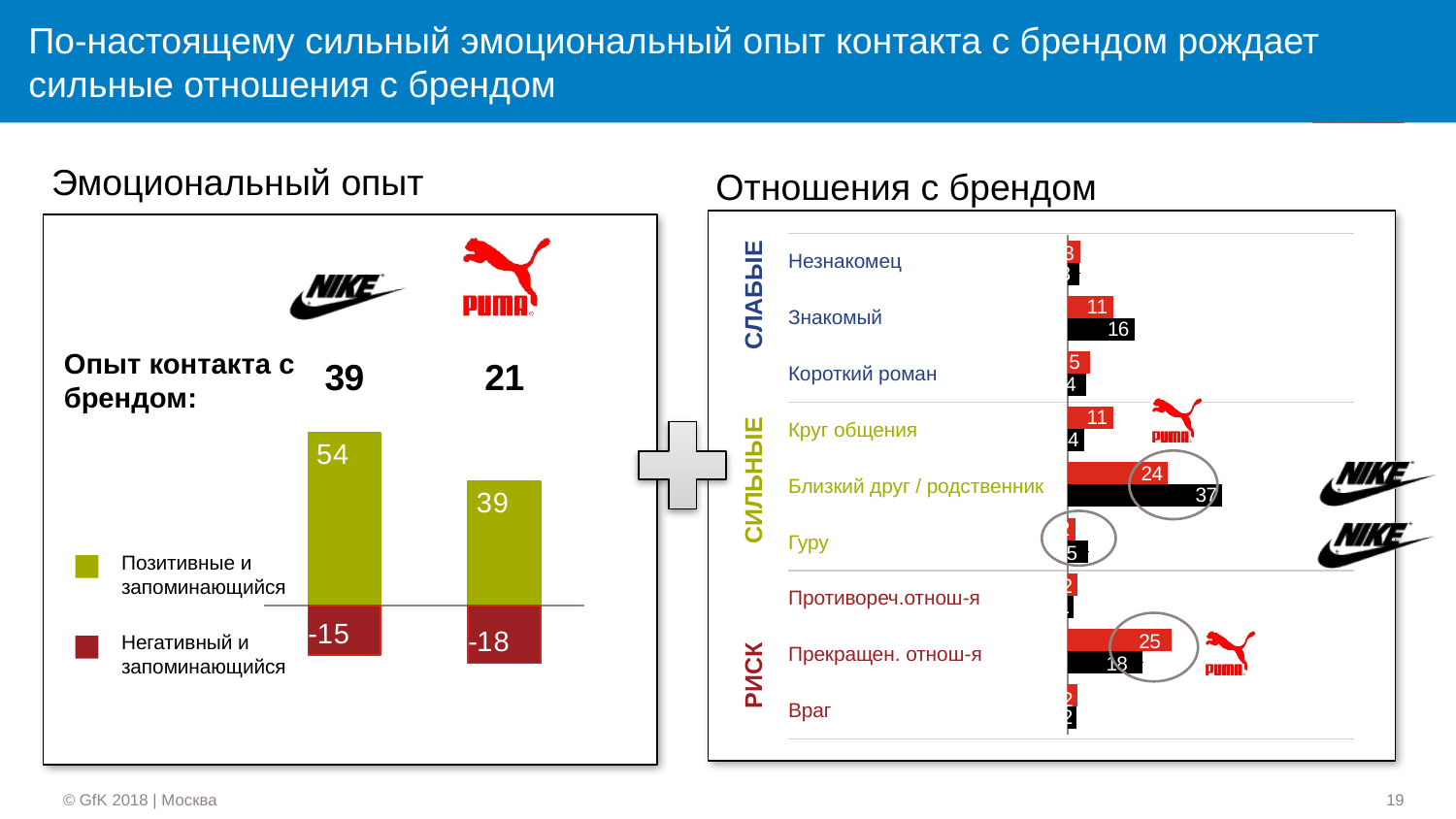
In the 'Отношения с брендом' chart, what is the value of the red bar for 'Прекращен. отнош-я'? 25 In the 'Эмоциональный опыт' chart, what is the value of the 'Позитивные и запоминающийся' segment for Nike? 54 In the 'Эмоциональный опыт' chart, what is the value of the 'Негативный и запоминающийся' segment for Puma? -18 In the 'Отношения с брендом' chart, what is the value of the black bar for 'Близкий друг / родственник'? 37 What type of chart is the 'Эмоциональный опыт' chart? Bar chart In the 'Эмоциональный опыт' chart, what is the difference between the positive values for Nike and Puma? 15 In the 'Отношения с брендом' chart, how many categories are shown? 9 In the 'Эмоциональный опыт' chart, which brand has the larger 'Позитивные и запоминающийся' value, Nike or Puma? Nike In the 'Эмоциональный опыт' chart, how many series does the legend list? 2 In the 'Эмоциональный опыт' chart, what is the value of the 'Негативный и запоминающийся' segment for Nike? -15 In the 'Отношения с брендом' chart, what is the value of the black bar for 'Знакомый'? 16 In the 'Отношения с брендом' chart, which category has the highest black bar? Близкий друг / родственник